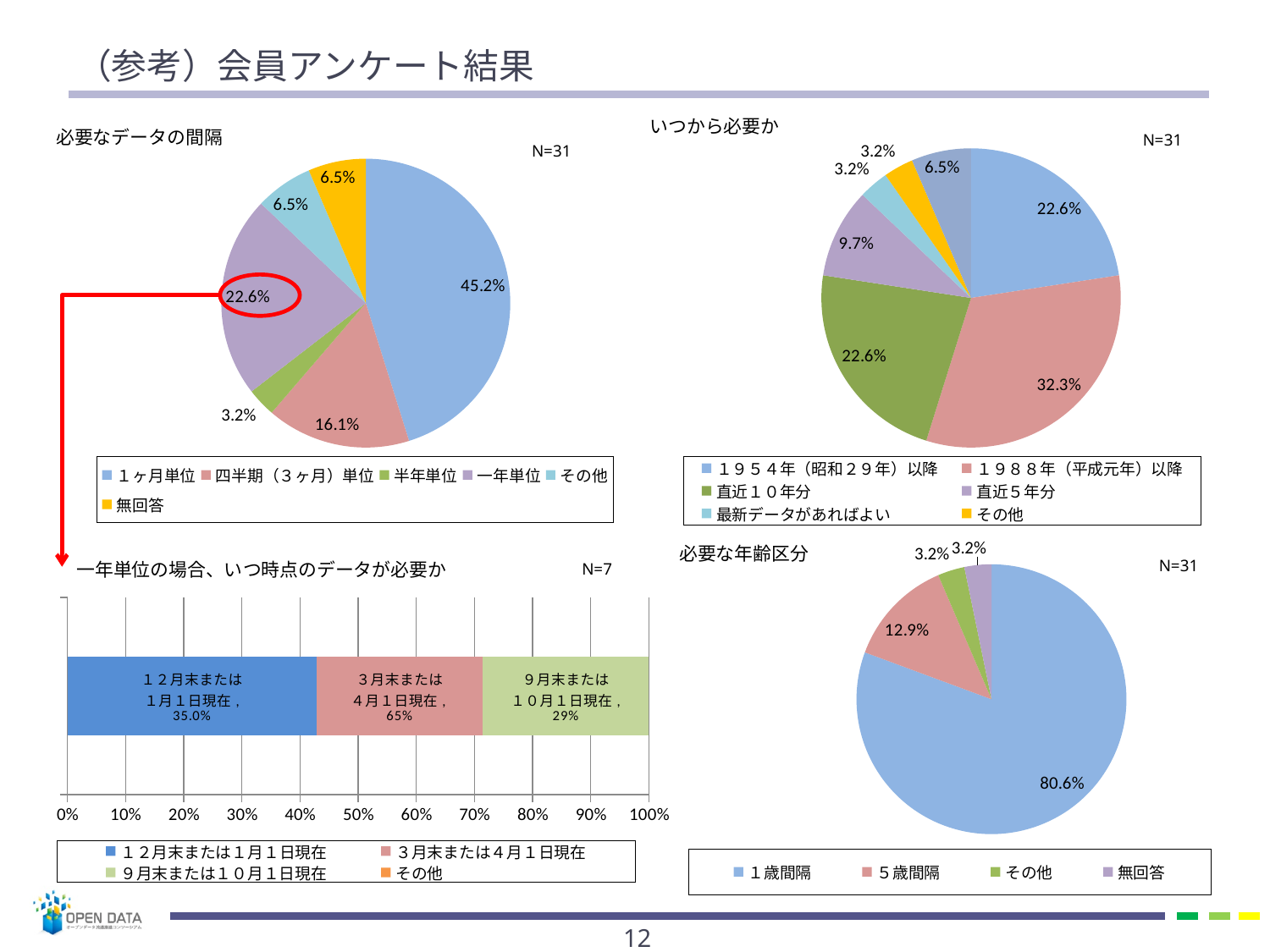
In the 必要なデータの間隔 pie chart, which category has the largest share? 1ヶ月単位 In the いつから必要か pie chart, what share is shown for 直近5年分? 9.7% In the いつから必要か pie chart, what share is shown for 1988年（平成元年）以降? 32.3% In the 必要なデータの間隔 pie chart, what share is shown for 1ヶ月単位? 45.2% What is the N value shown for the 一年単位の場合、いつ時点のデータが必要か chart? N=7 In the いつから必要か pie chart, which is larger: the share for 1988年（平成元年）以降 or the share for 直近10年分? 1988年（平成元年）以降 How many entries does the legend of the 必要なデータの間隔 pie chart list? 6 What kind of chart is the 一年単位の場合、いつ時点のデータが必要か chart at the bottom left? bar chart In the 必要な年齢区分 pie chart, what is the difference between the shares for 1歳間隔 and 5歳間隔? 67.7% In the 必要なデータの間隔 pie chart, what is the difference between the shares for 1ヶ月単位 and 四半期（3ヶ月）単位? 29.1%